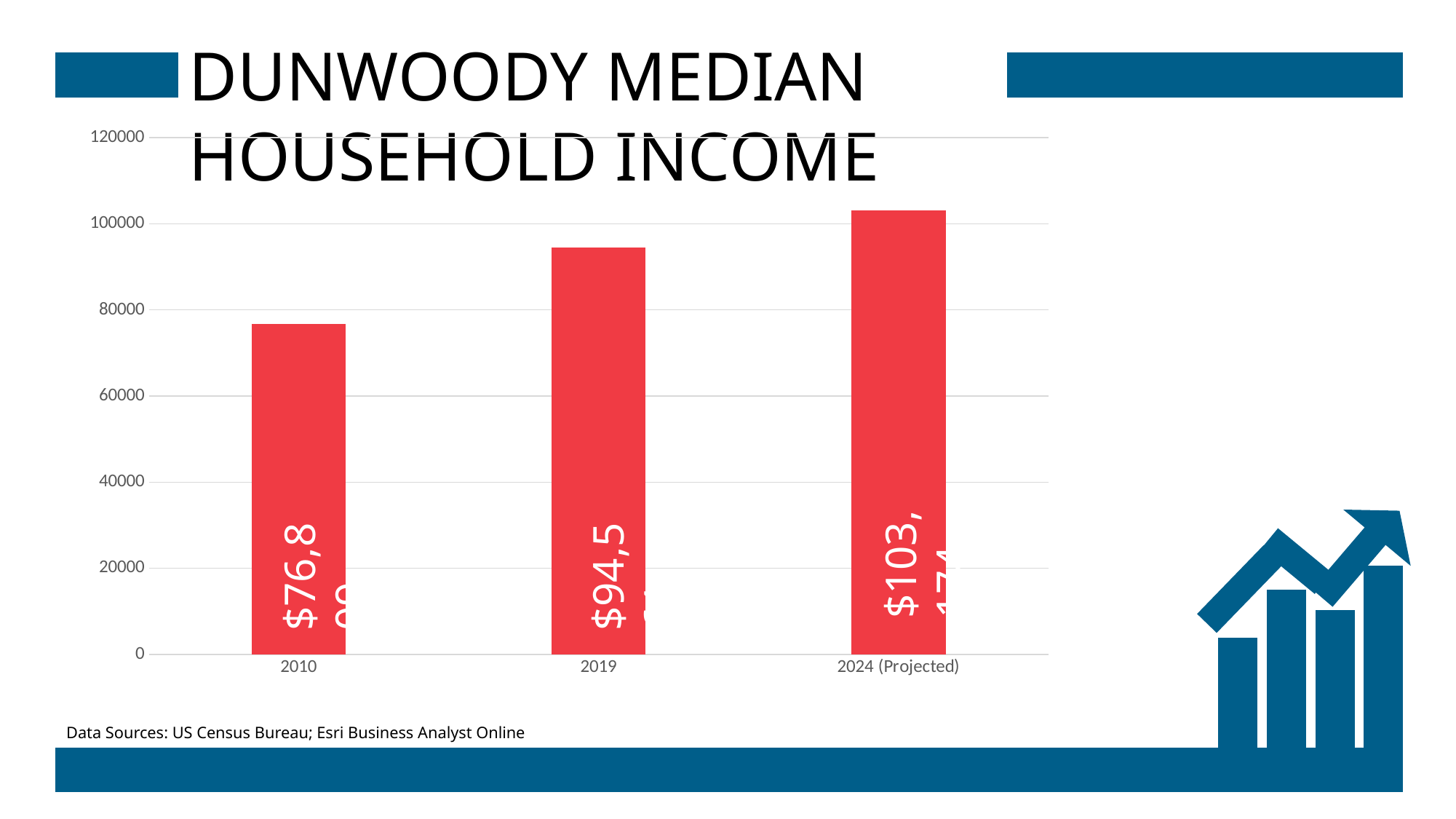
Which category has the highest median household income? 2024 (Projected) Which category has the lowest median household income? 2010 Is the value for 2010 greater or less than 80000? less Is the value for 2019 greater or less than 100000? less Which is larger, the value for 2010 or the value for 2019? 2019 How many bars (categories) are plotted in the chart? 3 Do the values rise or fall from 2010 to 2024 (Projected)? rise Is the value for 2019 greater or less than 80000? greater What colour are the bars in the chart? red What kind of chart is shown on the slide? bar chart What is the title of the chart? DUNWOODY MEDIAN HOUSEHOLD INCOME